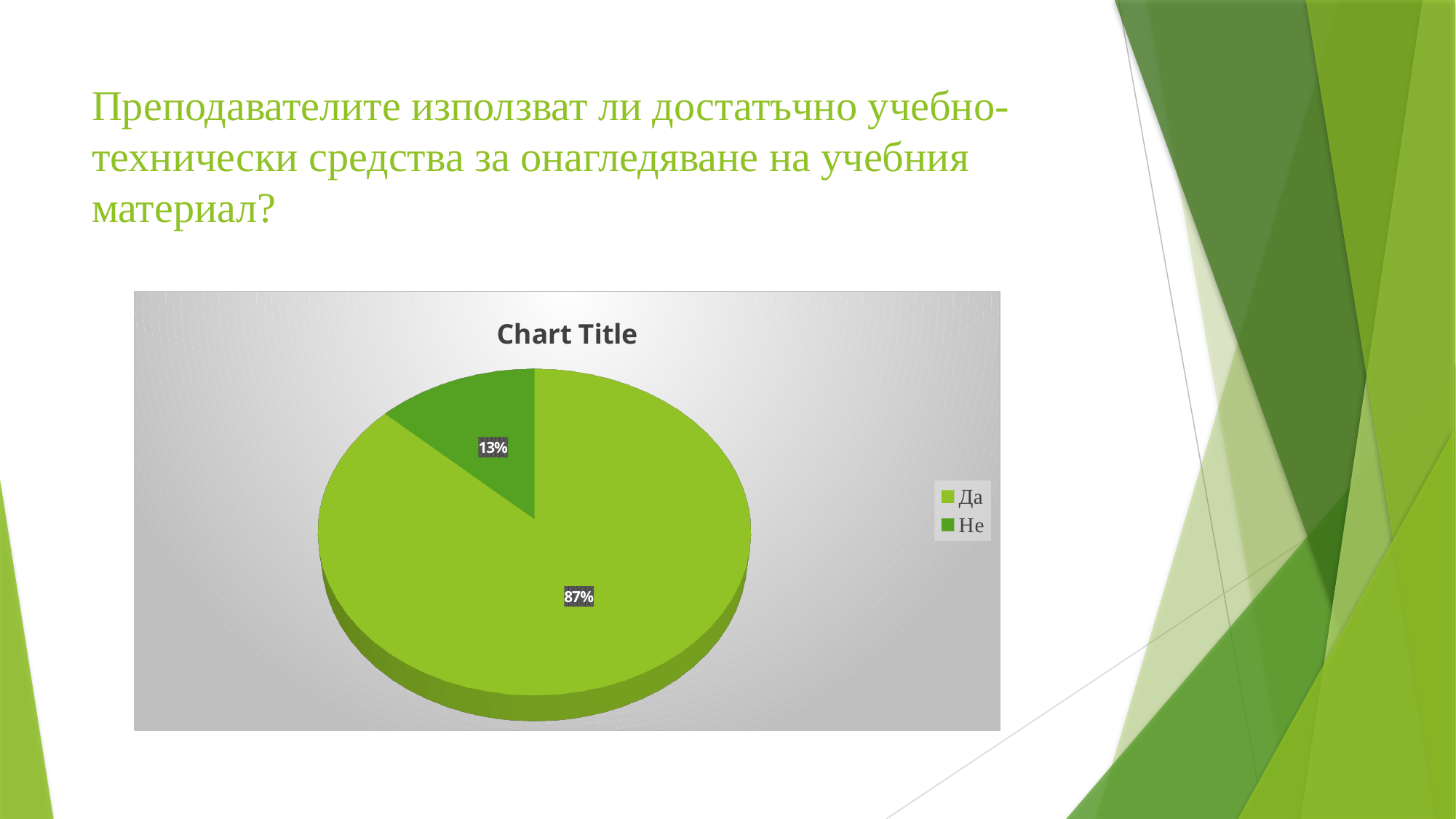
What share of the pie does "Не" represent? 13% What is the difference in percentage points between the "Да" and "Не" slices? 74 Which legend entry is shown in the darker green colour? Не Which is larger, the "Да" slice or the "Не" slice? Да What kind of chart is shown on the slide? pie chart Which category has the smallest slice of the pie? Не How many entries does the legend list? 2 Which category has the largest slice of the pie? Да What is the title shown on the chart? Chart Title How many categories does the pie chart show? 2 What share of the pie does "Да" represent? 87%